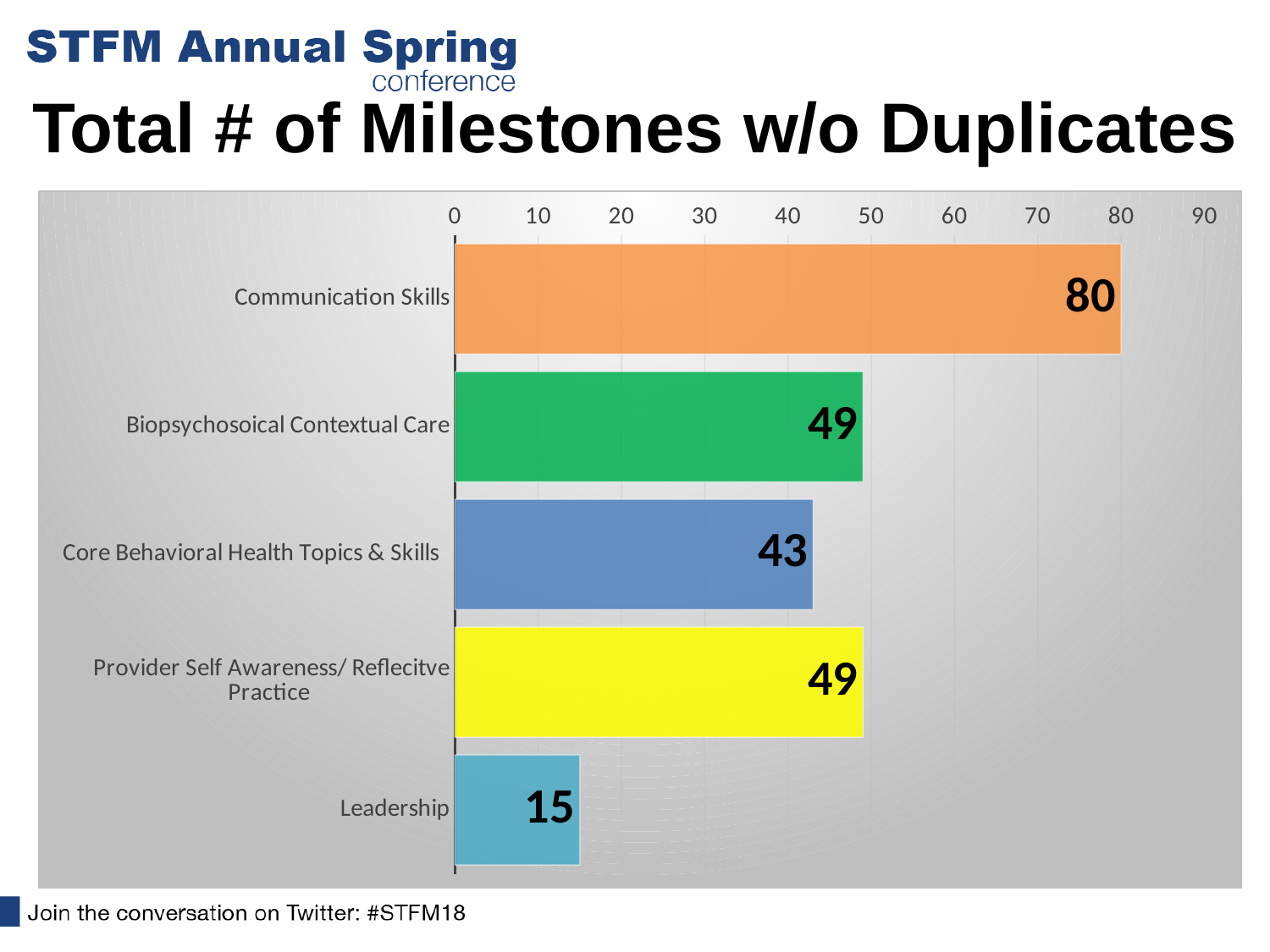
What is the value for Core Behavioral Health Topics & Skills? 43 Which is larger, the value for Core Behavioral Health Topics & Skills or the value for Provider Self Awareness/ Reflecitve Practice? Provider Self Awareness/ Reflecitve Practice What is the title of the chart? Total # of Milestones w/o Duplicates What is the value for Communication Skills? 80 What is the value for Biopsychosoical Contextual Care? 49 What is the difference between the values for Communication Skills and Leadership? 65 Which category has the lowest value? Leadership Which category has the highest value? Communication Skills How many categories are shown in the chart? 5 What is the difference between the values for Biopsychosoical Contextual Care and Core Behavioral Health Topics & Skills? 6 What kind of chart is shown on the slide? bar chart What is the value for Leadership? 15